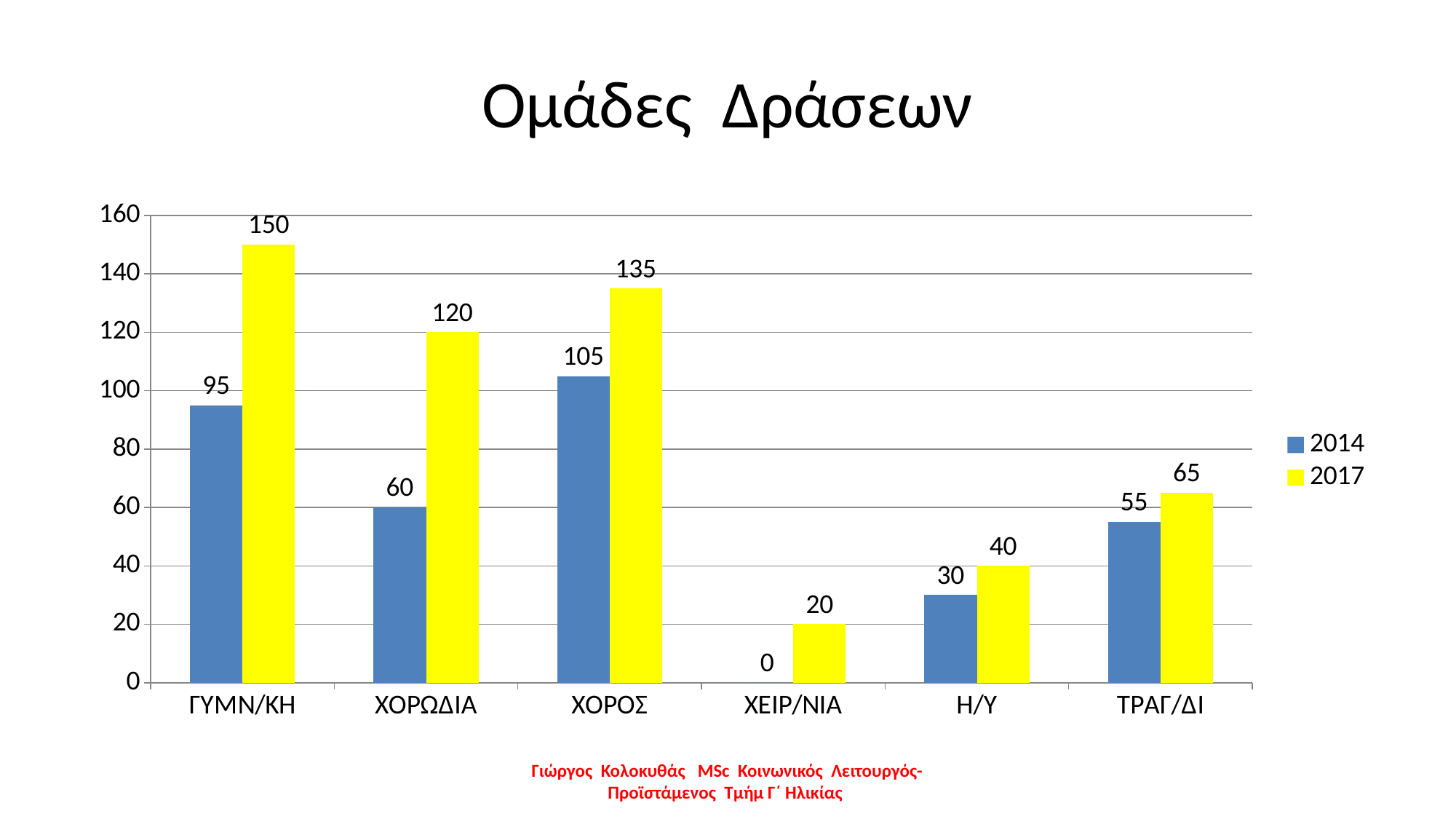
Which category has the highest value in 2017? ΓΥΜΝ/ΚΗ Which colour represents the 2017 series? Yellow How many series does the legend list? 2 How many categories are shown on the x axis? 6 What is the value for ΓΥΜΝ/ΚΗ in 2017? 150 Which category has the lowest value in 2014? ΧΕΙΡ/ΝΙΑ What kind of chart is shown on the slide? Bar chart What is the title of the chart? Ομάδες Δράσεων What is the difference between the 2017 and 2014 values for ΧΟΡΩΔΙΑ? 60 Which is larger: the 2014 value for ΧΟΡΟΣ or the 2017 value for ΧΟΡΩΔΙΑ? 2017 value for ΧΟΡΩΔΙΑ What is the value for ΧΟΡΟΣ in 2014? 105 What is the value for ΧΕΙΡ/ΝΙΑ in 2014? 0